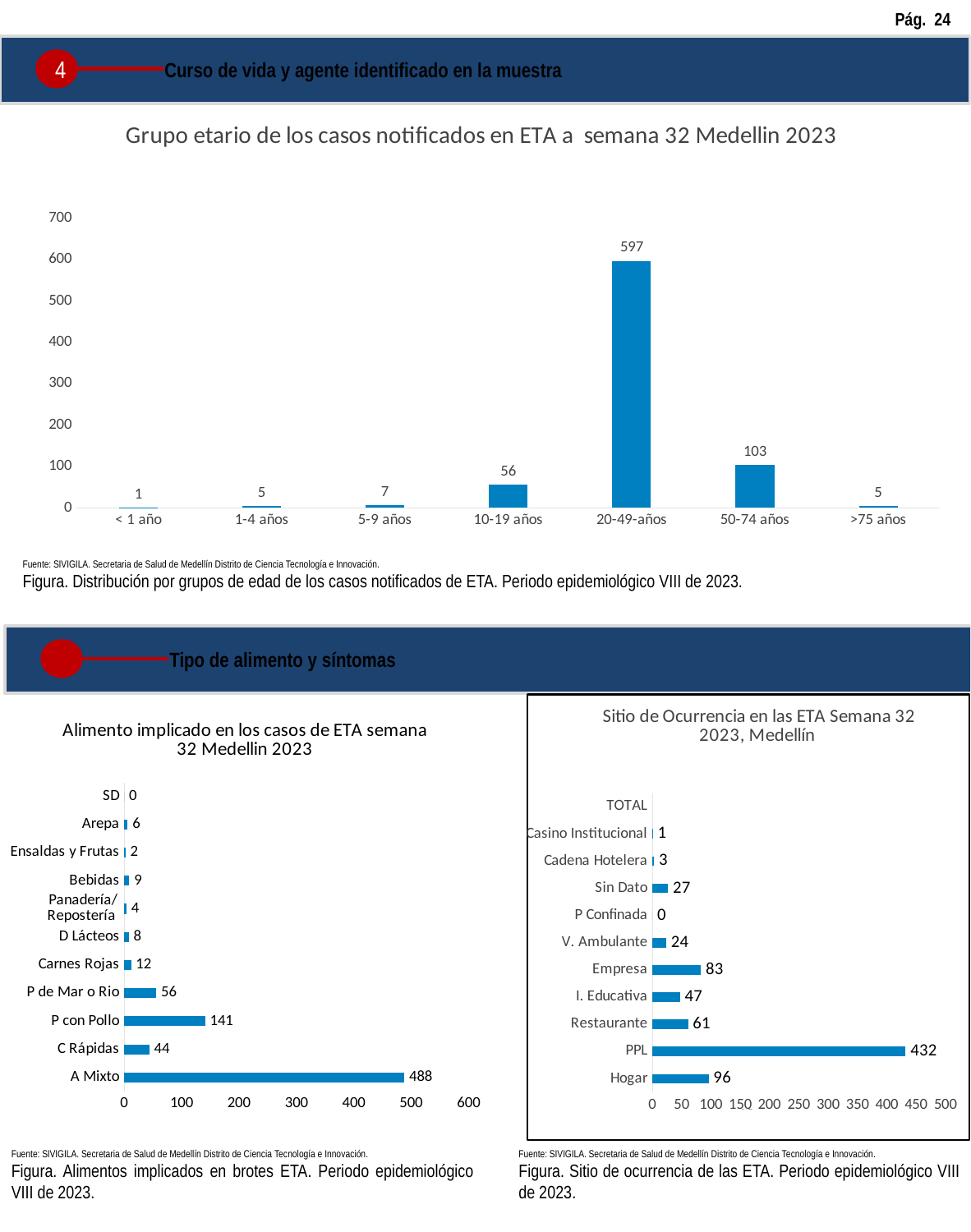
In the chart 'Grupo etario de los casos notificados en ETA a semana 32 Medellin 2023', what is the difference between the values for 50-74 años and 10-19 años? 47 In the chart 'Alimento implicado en los casos de ETA semana 32 Medellin 2023', which food category has the highest value? A Mixto How many food categories are listed in the chart 'Alimento implicado en los casos de ETA semana 32 Medellin 2023'? 11 In the chart 'Grupo etario de los casos notificados en ETA a semana 32 Medellin 2023', what is the value for 20-49-años? 597 In the chart 'Alimento implicado en los casos de ETA semana 32 Medellin 2023', which is larger, P de Mar o Rio or C Rápidas? P de Mar o Rio In the chart 'Sitio de Ocurrencia en las ETA Semana 32 2023, Medellín', what is the value for Hogar? 96 In the chart 'Sitio de Ocurrencia en las ETA Semana 32 2023, Medellín', which site has the highest value? PPL How many age groups are shown in the chart 'Grupo etario de los casos notificados en ETA a semana 32 Medellin 2023'? 7 In the chart 'Alimento implicado en los casos de ETA semana 32 Medellin 2023', what is the value for P con Pollo? 141 In the chart 'Sitio de Ocurrencia en las ETA Semana 32 2023, Medellín', what is the difference between the values for Empresa and Restaurante? 22 In the chart 'Grupo etario de los casos notificados en ETA a semana 32 Medellin 2023', which age group has the lowest value? < 1 año What kind of chart is 'Grupo etario de los casos notificados en ETA a semana 32 Medellin 2023'? Bar chart